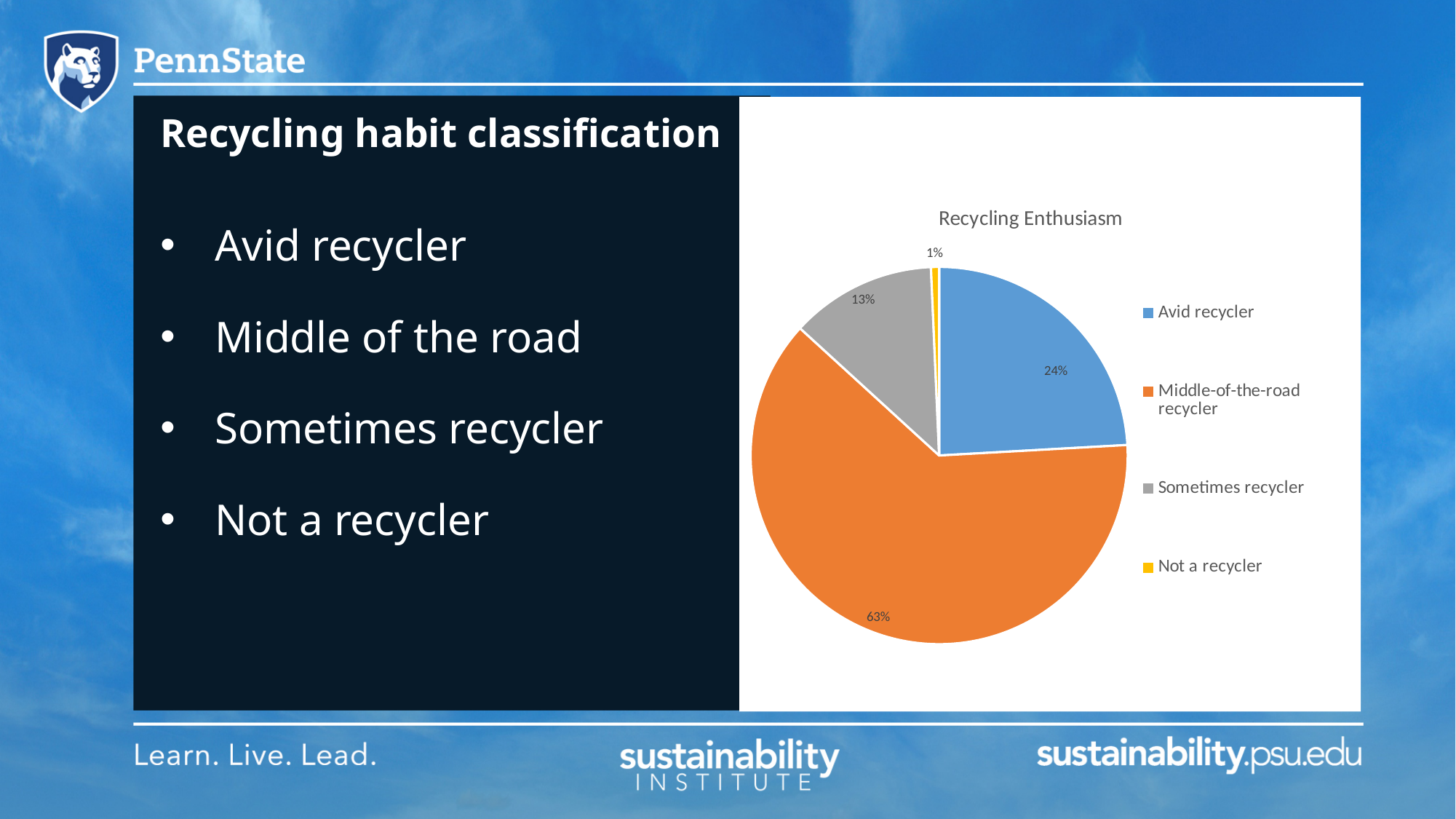
Which category has the largest share of the pie? Middle-of-the-road recycler Which category has the smallest share of the pie? Not a recycler Which is larger, the share for Avid recycler or the share for Sometimes recycler? Avid recycler What is the difference in percentage points between Middle-of-the-road recycler and Avid recycler? 39 What kind of chart is shown on the slide? pie chart What percentage of the pie is Sometimes recycler? 13% How many categories does the pie chart show? 4 What colour is the Sometimes recycler slice? gray What is the title of the chart? Recycling Enthusiasm What percentage of the pie is Middle-of-the-road recycler? 63% What percentage of the pie is Avid recycler? 24% What percentage of the pie is Not a recycler? 1%